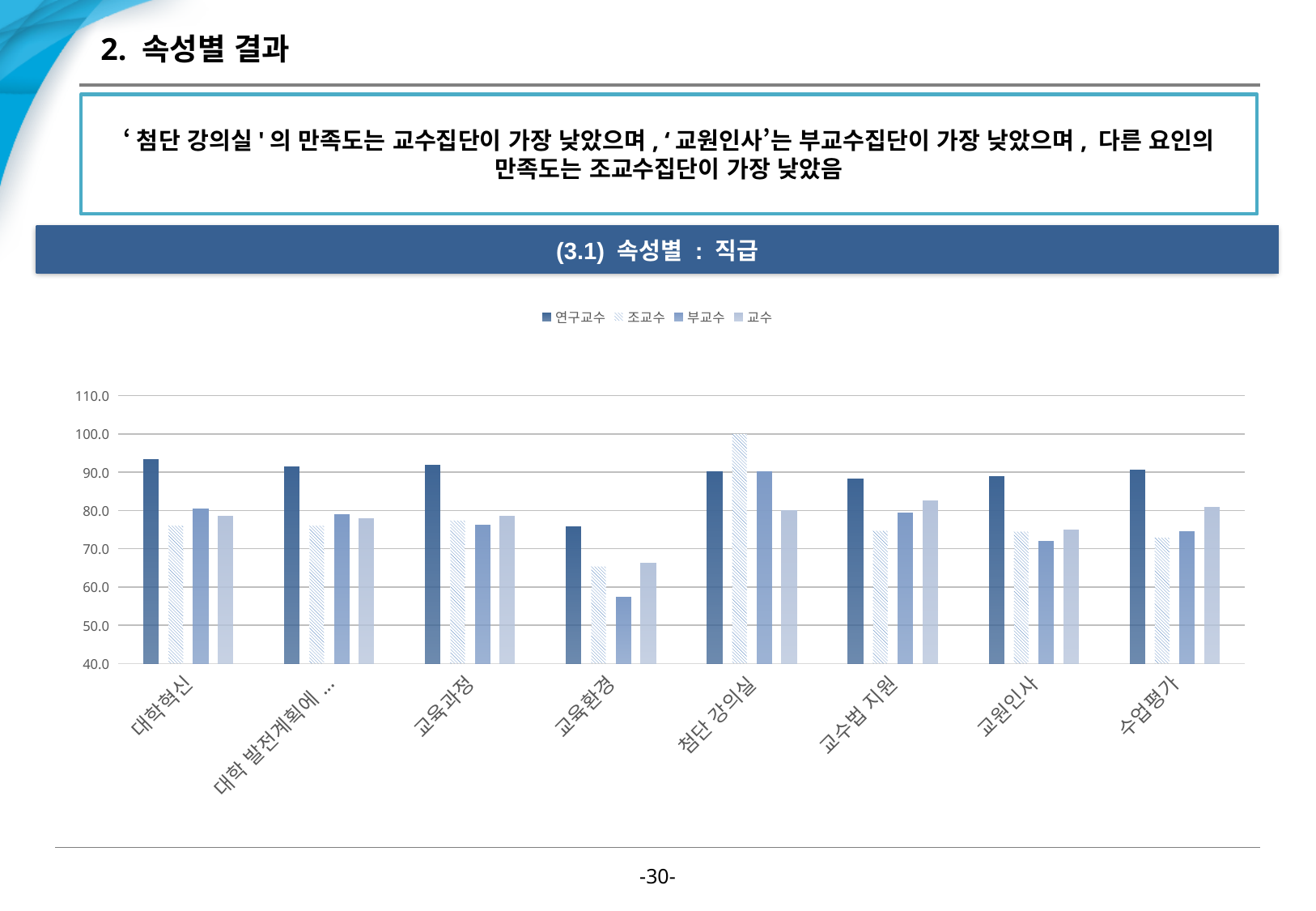
Which series is listed first in the chart's legend? 연구교수 What kind of chart is shown on the slide? bar chart For the 연구교수 series, which category has the lowest value? 교육환경 How many series does the chart's legend list? 4 How many categories are shown along the x axis of the chart? 8 Is the value for 연구교수 in the 교육환경 category greater or less than 80? less Is the value for 교수 in the 교육환경 category greater or less than 60? greater Is the value for 조교수 in the 첨단 강의실 category greater or less than 90? greater In the 교육환경 category, which series has the lowest value? 부교수 In the 첨단 강의실 category, which series has the highest value? 조교수